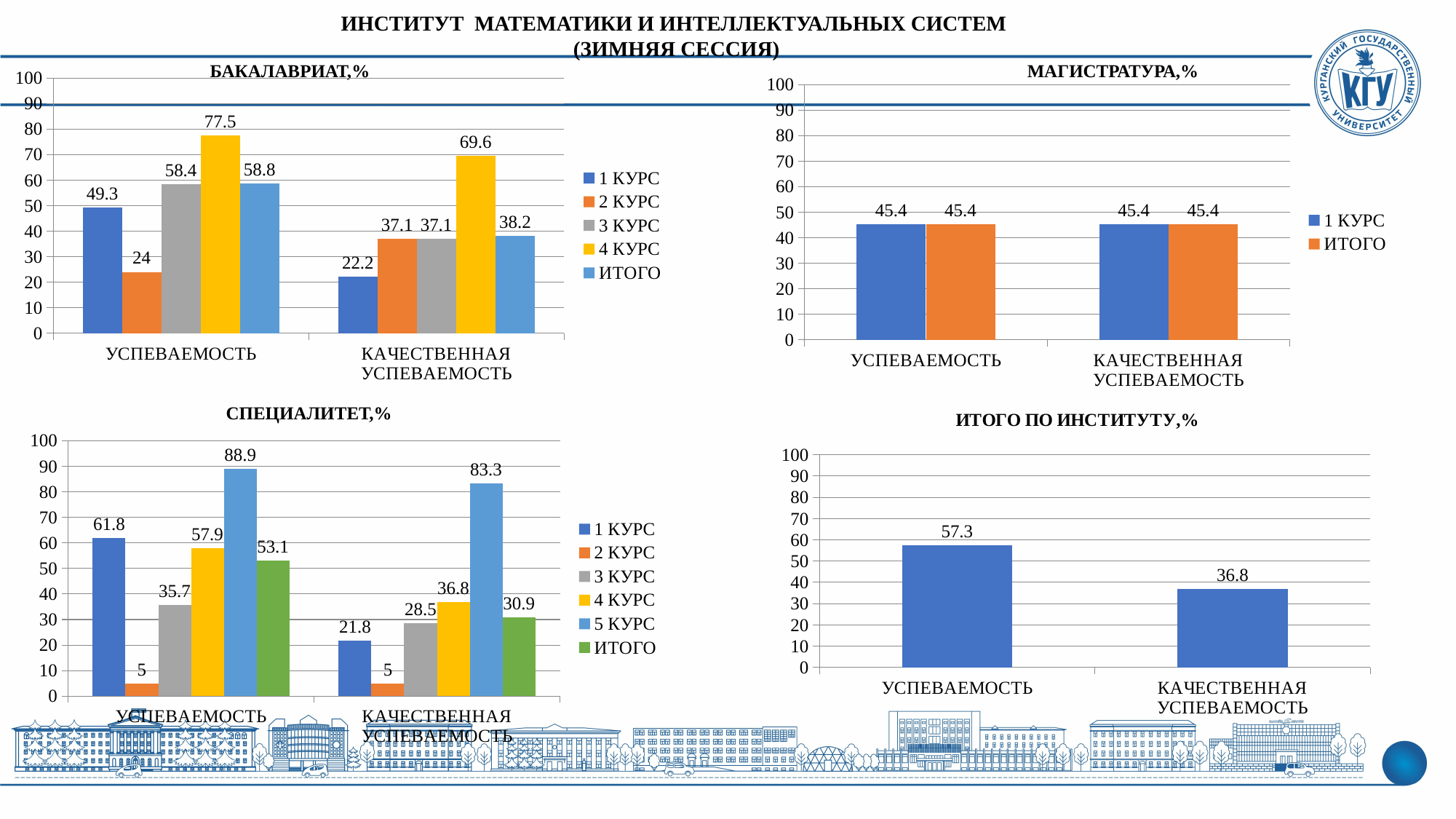
In the БАКАЛАВРИАТ,% chart, what is the difference between the 4 КУРС and 1 КУРС values under КАЧЕСТВЕННАЯ УСПЕВАЕМОСТЬ? 47.4 In the СПЕЦИАЛИТЕТ,% chart, which is larger under КАЧЕСТВЕННАЯ УСПЕВАЕМОСТЬ: 3 КУРС or 4 КУРС? 4 КУРС In the ИТОГО ПО ИНСТИТУТУ,% chart, what is the value for УСПЕВАЕМОСТЬ? 57.3 In the БАКАЛАВРИАТ,% chart, what is the value for 4 КУРС under УСПЕВАЕМОСТЬ? 77.5 In the МАГИСТРАТУРА,% chart, what is the value for ИТОГО under КАЧЕСТВЕННАЯ УСПЕВАЕМОСТЬ? 45.4 In the СПЕЦИАЛИТЕТ,% chart, what is the value for 2 КУРС under КАЧЕСТВЕННАЯ УСПЕВАЕМОСТЬ? 5 In the СПЕЦИАЛИТЕТ,% chart, which series has the highest value under УСПЕВАЕМОСТЬ? 5 КУРС In the ИТОГО ПО ИНСТИТУТУ,% chart, what is the difference between УСПЕВАЕМОСТЬ and КАЧЕСТВЕННАЯ УСПЕВАЕМОСТЬ? 20.5 What kind of chart is the МАГИСТРАТУРА,% chart? bar chart How many series does the legend of the СПЕЦИАЛИТЕТ,% chart list? 6 In the БАКАЛАВРИАТ,% chart, which series has the lowest value under УСПЕВАЕМОСТЬ? 2 КУРС How many series does the legend of the БАКАЛАВРИАТ,% chart list? 5